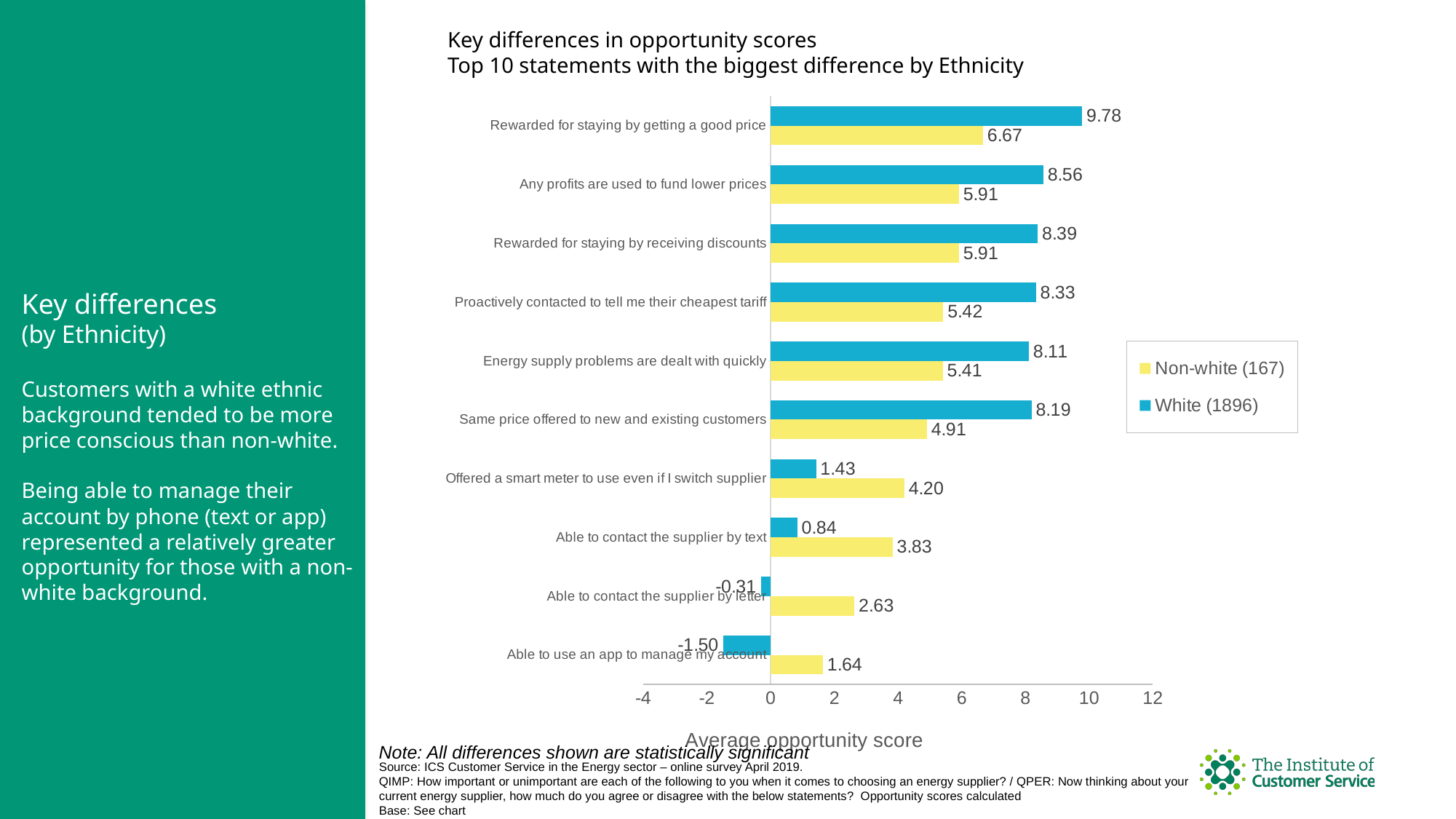
What type of chart is shown on the slide? Bar chart What is the White (1896) score for "Able to use an app to manage my account"? -1.50 Is the White (1896) score for "Any profits are used to fund lower prices" greater or less than 8? greater How many statements are shown in the chart? 10 What is the Non-white (167) opportunity score for "Able to contact the supplier by text"? 3.83 For "Offered a smart meter to use even if I switch supplier", which group has the higher score, Non-white (167) or White (1896)? Non-white (167) What is the difference between the White (1896) and Non-white (167) scores for "Same price offered to new and existing customers"? 3.28 Which statement has the highest White (1896) opportunity score? Rewarded for staying by getting a good price What is the label of the horizontal axis of the chart? Average opportunity score Which statement has the lowest Non-white (167) opportunity score? Able to use an app to manage my account What is the White (1896) opportunity score for "Rewarded for staying by getting a good price"? 9.78 How many series does the legend list? 2